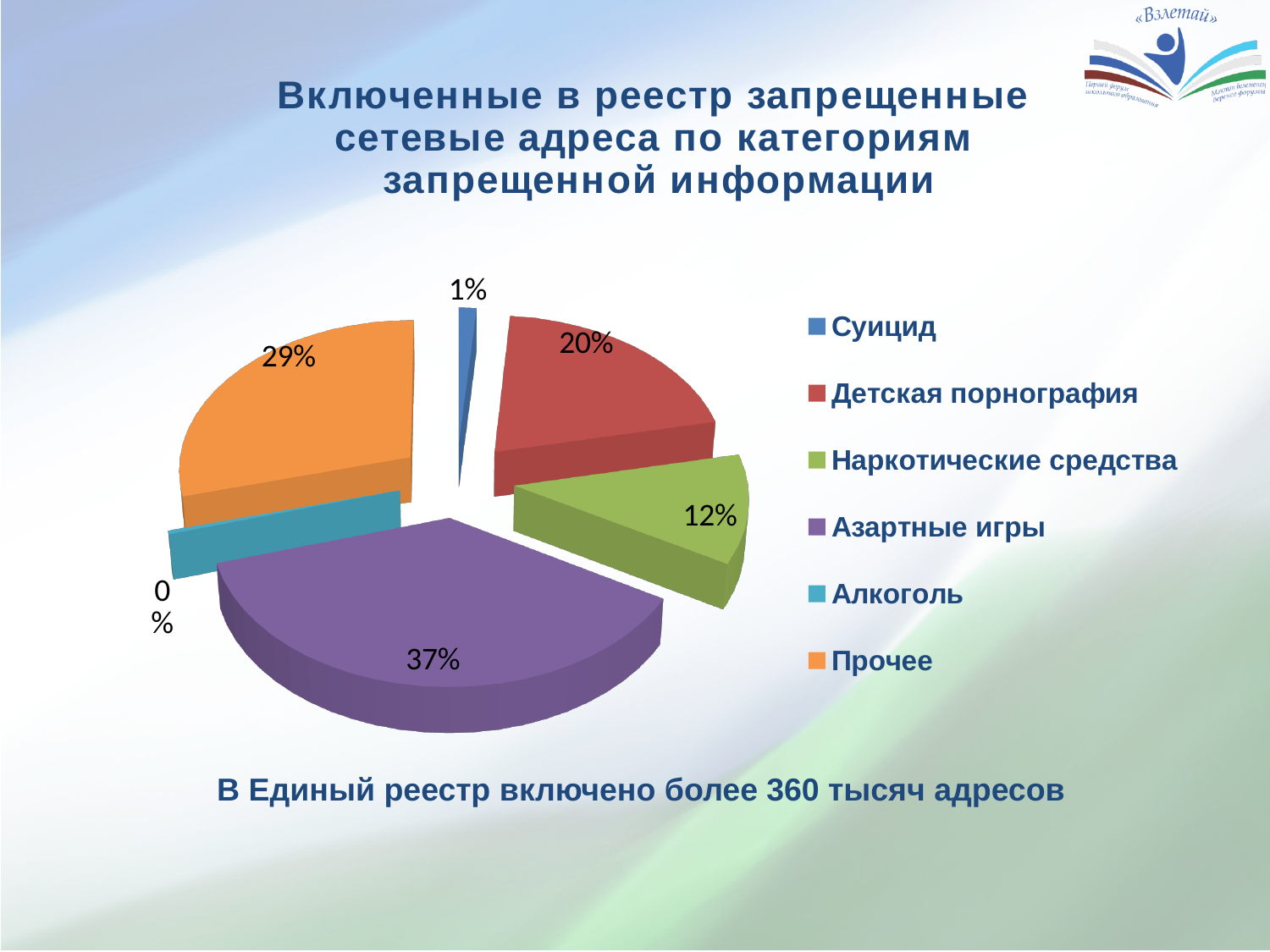
What type of chart is shown on the slide? Pie chart What share of the pie does Наркотические средства have? 12% Which category has the largest share of the pie? Азартные игры What share of the pie does Прочее have? 29% What share of the pie does Суицид have? 1% What share of the pie does Азартные игры have? 37% Which has a larger share, Детская порнография or Наркотические средства? Детская порнография Which category has the smallest share of the pie? Алкоголь What is the difference in percentage points between Азартные игры and Прочее? 8 What share of the pie does Детская порнография have? 20% How many categories does the legend list? 6 What colour is the slice for Прочее? Orange